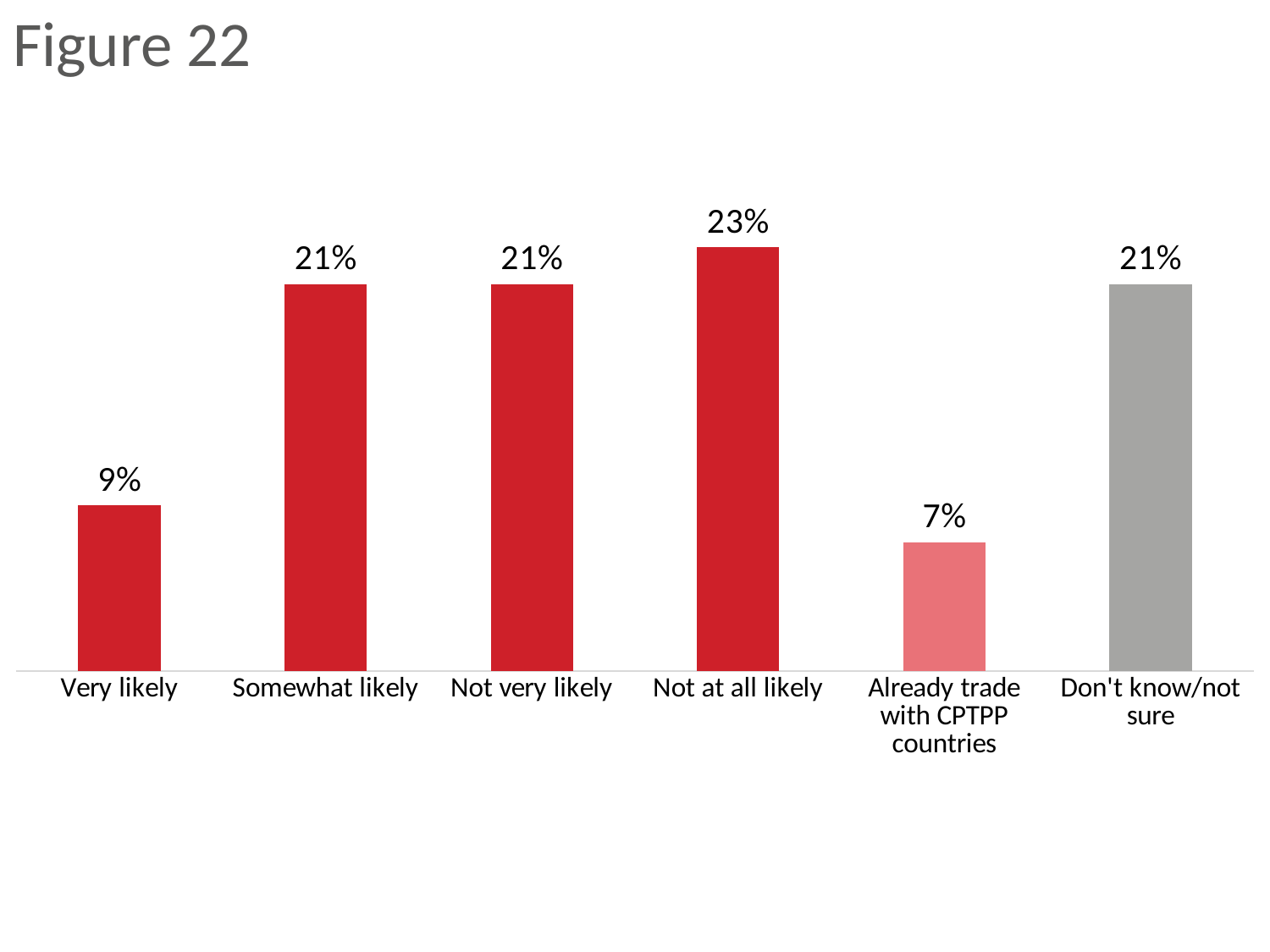
What is the difference between the values for "Somewhat likely" and "Already trade with CPTPP countries"? 14% What is the value for "Already trade with CPTPP countries"? 7% What kind of chart is shown on the slide? Bar chart Which category has the highest value? Not at all likely What is the value for "Don't know/not sure"? 21% What is the value for "Very likely"? 9% Which is larger, the value for "Very likely" or the value for "Already trade with CPTPP countries"? Very likely How many categories are shown on the chart? 6 What is the value for "Not at all likely"? 23% What is the title shown at the top of the slide? Figure 22 What is the difference between the values for "Not at all likely" and "Very likely"? 14% Which category has the lowest value? Already trade with CPTPP countries